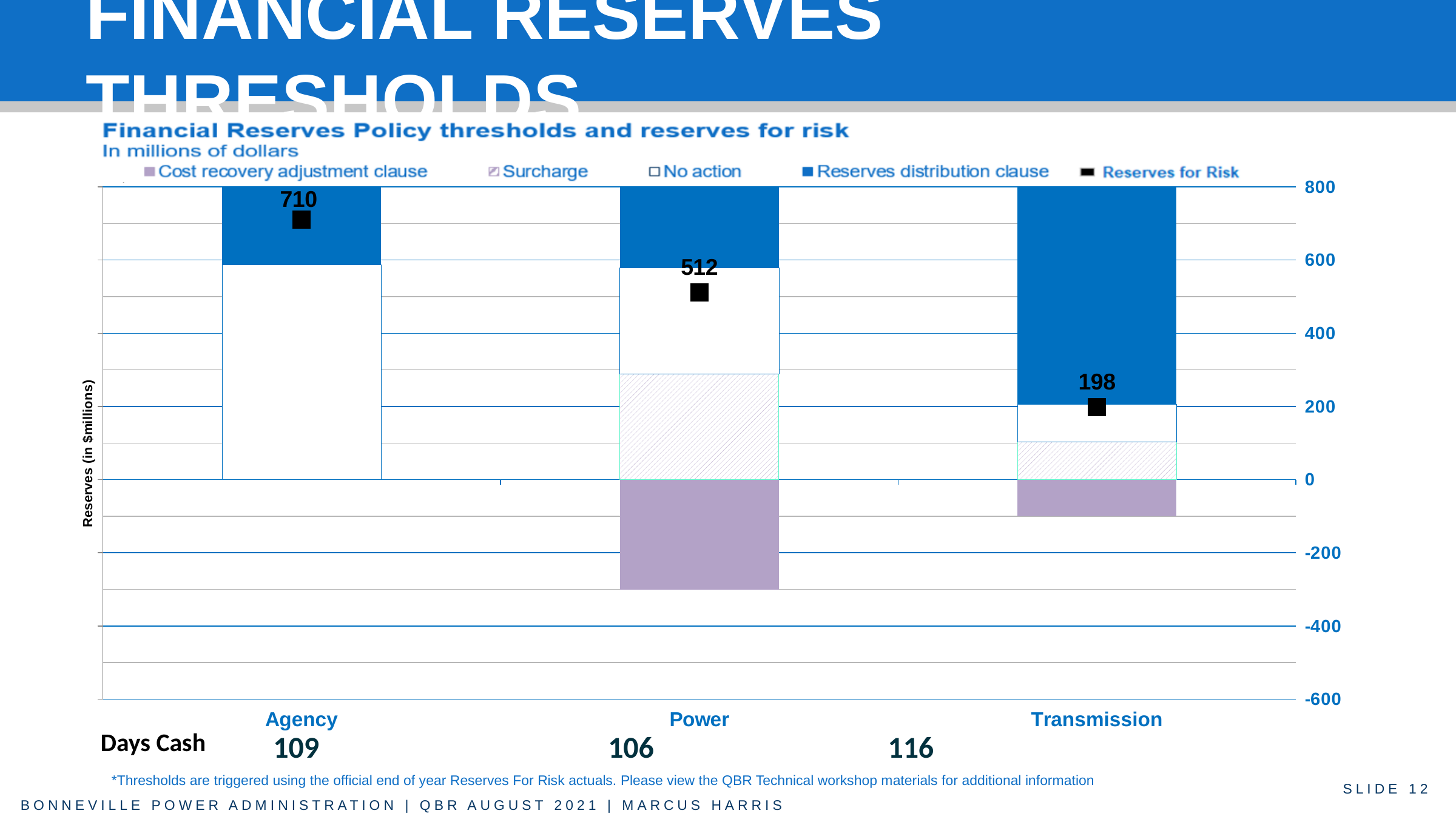
Which category has the lowest Reserves for Risk value? Transmission What is the difference between the Reserves for Risk values for Power and Transmission? 314 What is the Reserves for Risk value for Power? 512 Which category has the highest Reserves for Risk value? Agency What is the Reserves for Risk value for Transmission? 198 What is the Reserves for Risk value for Agency? 710 Which is larger, the Reserves for Risk value for Power or for Transmission? Power Is the Reserves for Risk value for Transmission greater or less than 400? less What is the title of the chart? Financial Reserves Policy thresholds and reserves for risk What is the difference between the Reserves for Risk values for Agency and Power? 198 How many categories are shown on the x axis of the chart? 3 How many series does the chart legend list? 5